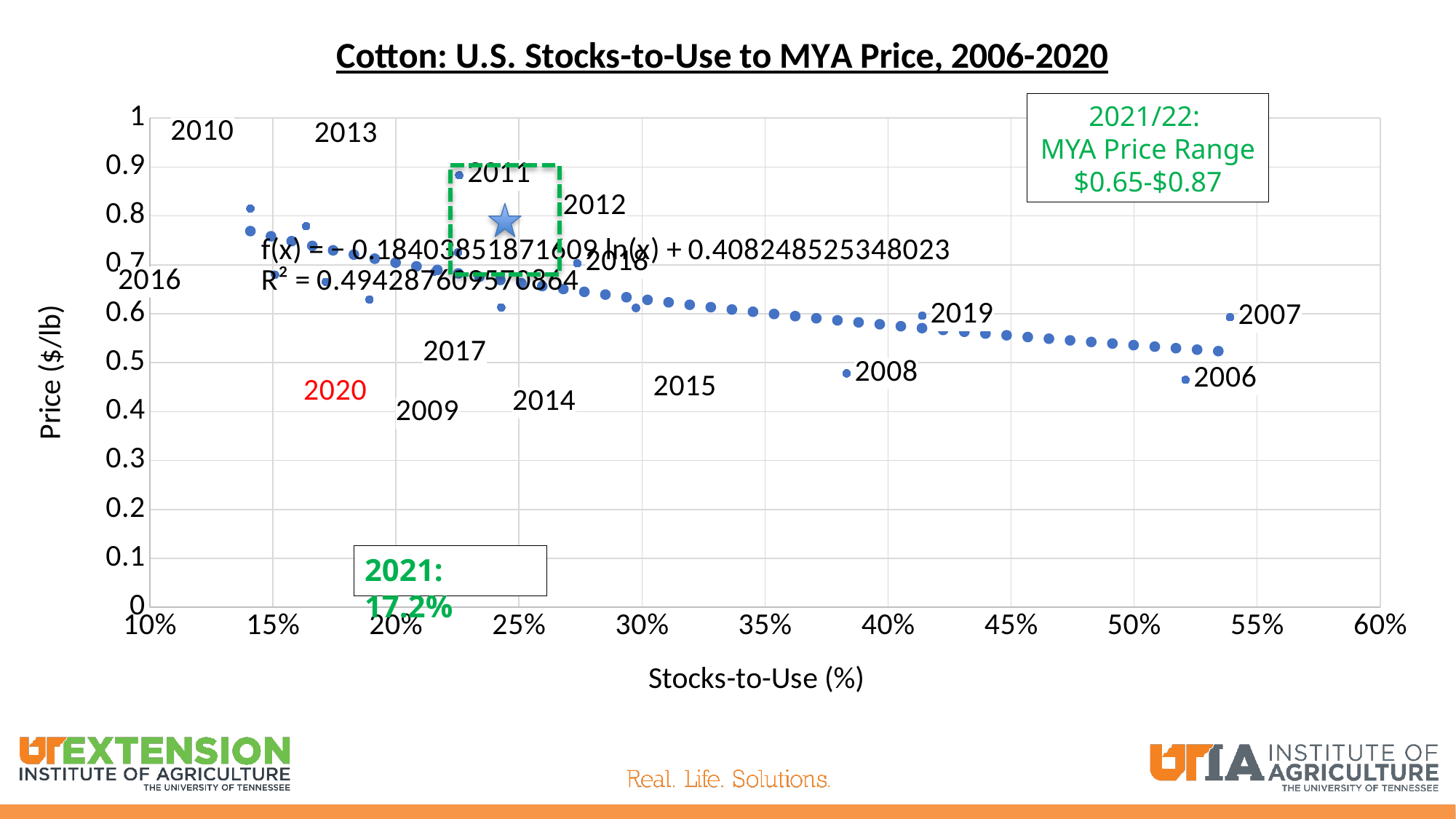
Is the stocks-to-use value for 2010 greater or less than 15%? less Which year has the higher price, 2011 or 2006? 2011 What kind of chart is shown on the slide? scatter chart Which year has the highest stocks-to-use value on the chart? 2007 What is the title of the chart? Cotton: U.S. Stocks-to-Use to MYA Price, 2006-2020 As stocks-to-use increases along the x axis, does the fitted trendline for price rise or fall? fall Is the stocks-to-use value for 2007 greater or less than 50%? greater How many year-labelled data points are plotted on the chart? 15 Is the price for 2006 greater or less than 0.5? less Which year has the highest MYA price on the chart? 2011 What is the label of the y axis? Price ($/lb)